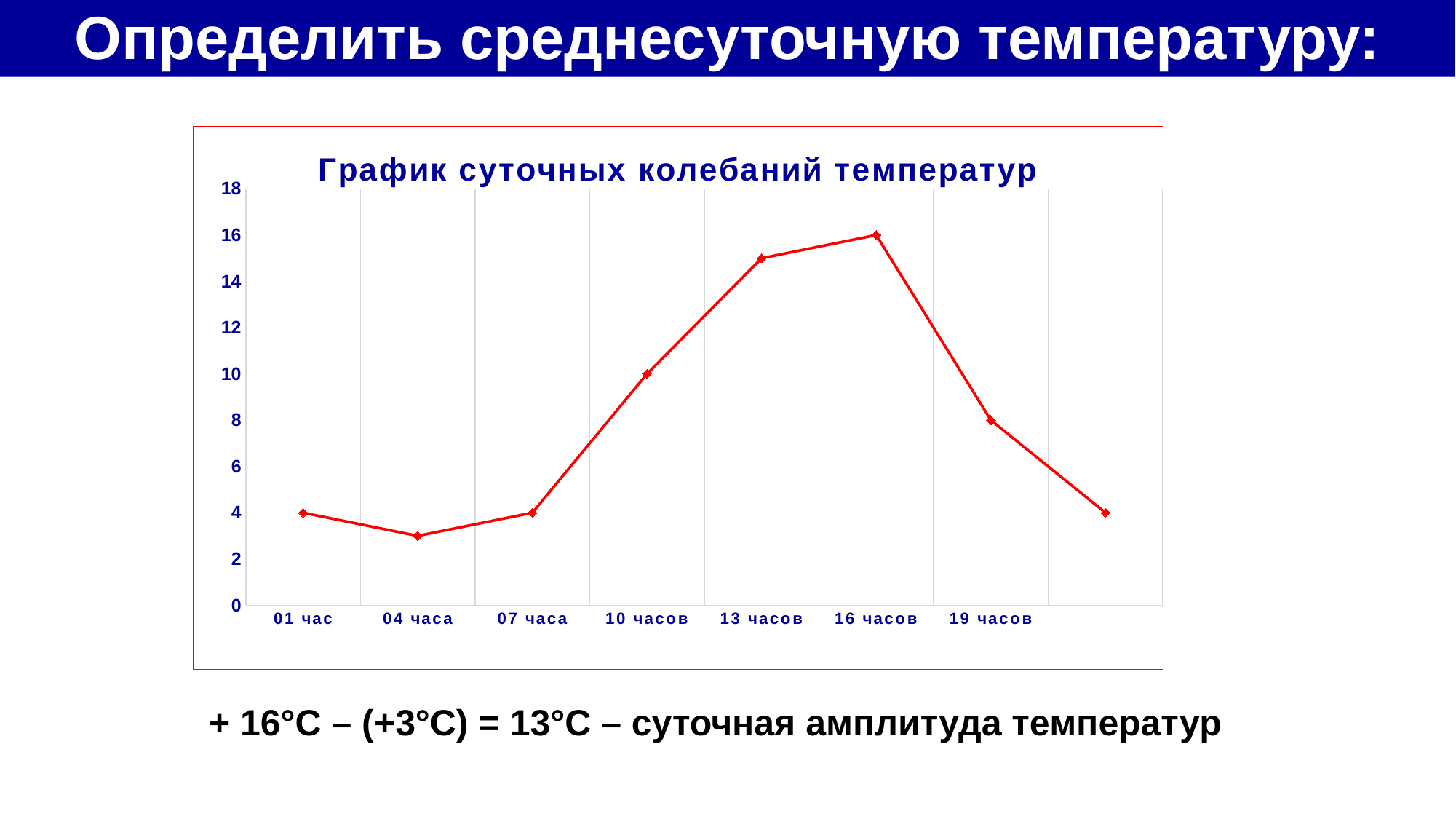
What is the difference between the values at 16 часов and 10 часов? 6 What is the temperature value at 01 час? 4 What is the title of the chart? График суточных колебаний температур Which is larger, the value at 10 часов or the value at 19 часов? 10 часов What is the temperature value at 19 часов? 8 What is the temperature value at 10 часов? 10 At which labeled time is the temperature highest? 16 часов What type of chart is shown on the slide? line chart Does the temperature rise or fall between 07 часа and 16 часов? rise What is the temperature value at 16 часов? 16 Is the value at 13 часов greater or less than 14? greater At which labeled time is the temperature lowest? 04 часа